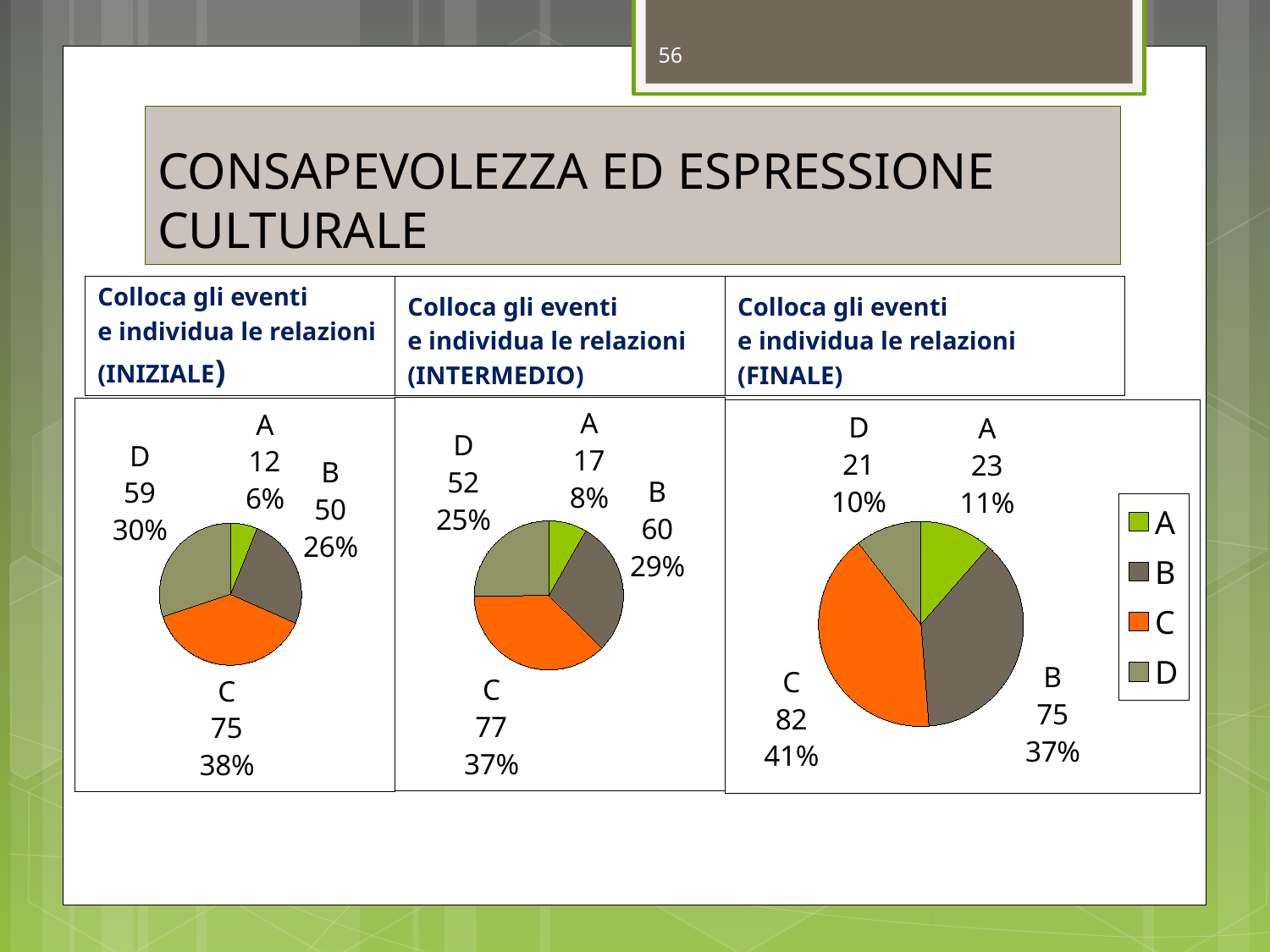
In the FINALE pie chart, what percentage share does category C have? 41% In the FINALE pie chart, what is the value for category D? 21 In the INTERMEDIO pie chart, which category has the largest slice? C In the INTERMEDIO pie chart, what is the value for category B? 60 In the INTERMEDIO pie chart, what is the difference between the values for C and D? 25 In the FINALE pie chart, which is larger, the value for A or the value for D? A How many categories does the legend on the right of the slide list? 4 In the INIZIALE pie chart, what is the value for category C? 75 In the INIZIALE pie chart, which category has the smallest slice? A What type of chart is used in the INIZIALE, INTERMEDIO and FINALE panels? Pie chart In the FINALE pie chart, what is the difference between the values for C and B? 7 In the INIZIALE pie chart, what percentage share does category A have? 6%